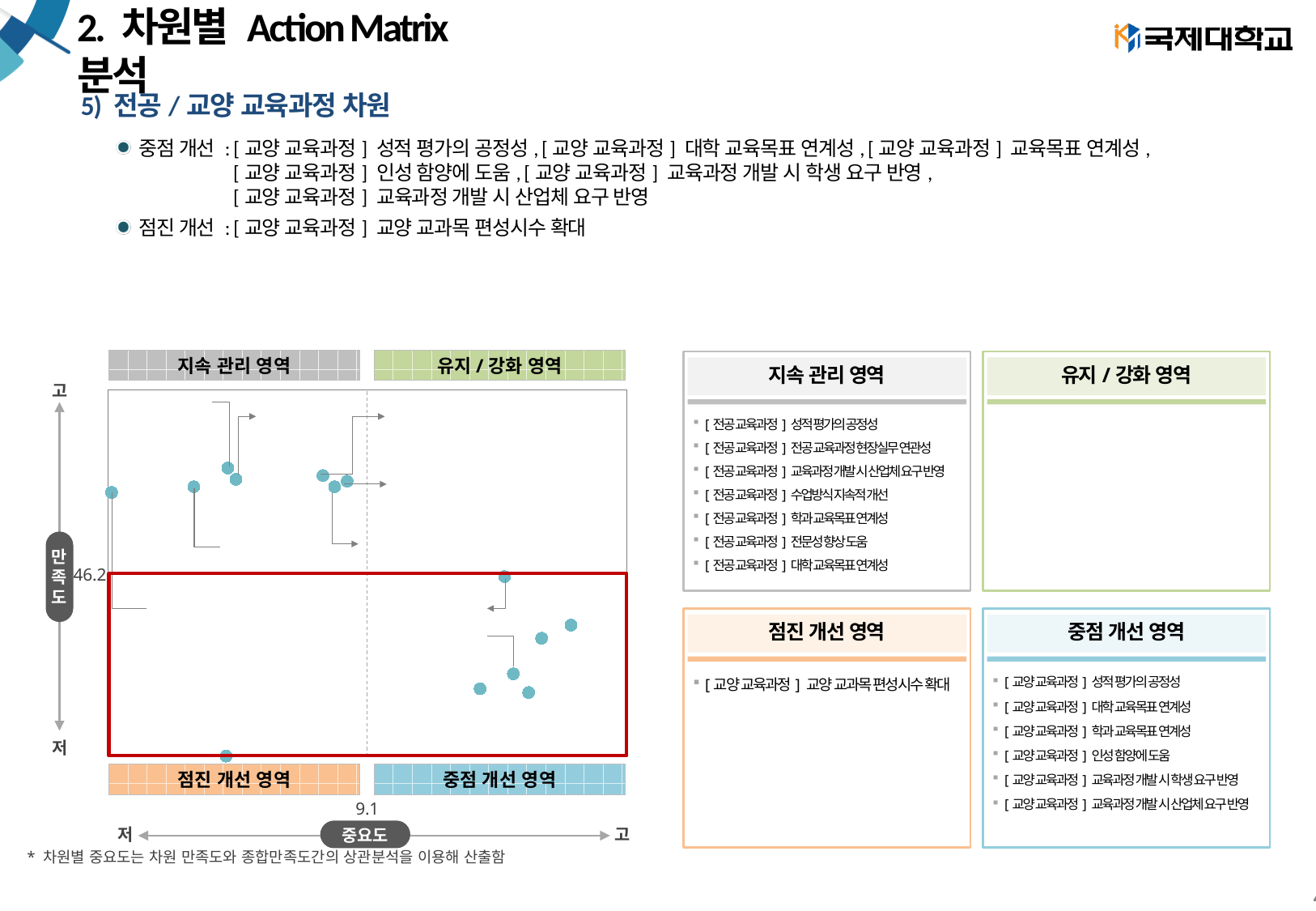
How many data points are plotted in total on the scatter chart? 14 Which quadrant of the scatter chart contains no data points? 유지 / 강화 영역 What kind of chart is shown on the left of the slide? scatter chart How many data points are plotted in the 지속 관리 영역 quadrant (top-left)? 7 What value is marked on the vertical (만족도) axis where the horizontal dividing line is drawn? 46.2 What value is marked on the horizontal (중요도) axis where the vertical dashed dividing line is drawn? 9.1 How many data points are plotted in the 점진 개선 영역 quadrant (bottom-left)? 1 What is the label of the vertical axis of the scatter chart? 만족도 What is the label of the horizontal axis of the scatter chart? 중요도 Which quadrant of the scatter chart contains the most data points? 지속 관리 영역